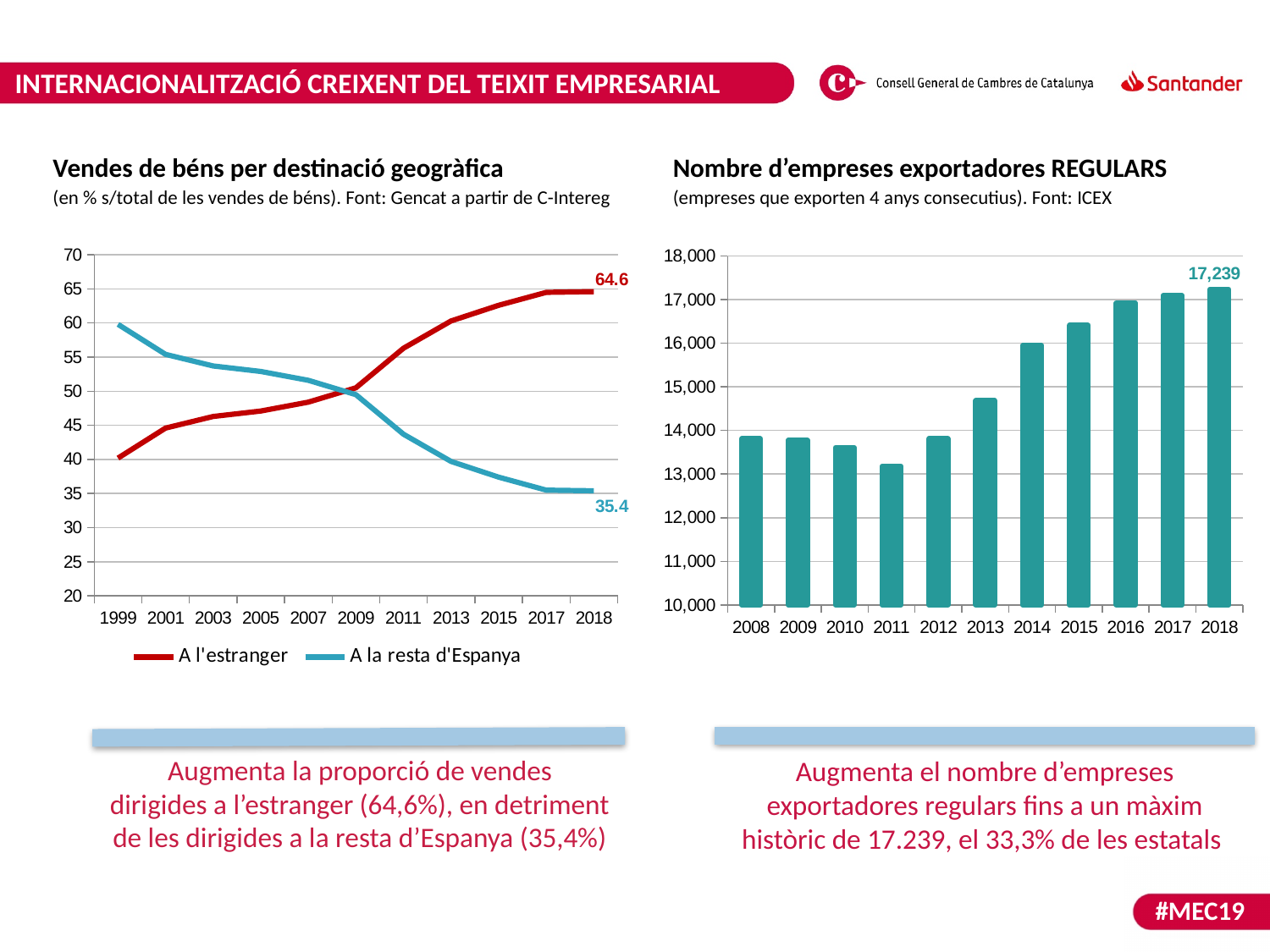
In the 'Vendes de béns per destinació geogràfica' chart, what is the value for 'A l'estranger' in 2018? 64.6 In the 'Vendes de béns per destinació geogràfica' chart, what is the value for 'A la resta d'Espanya' in 2018? 35.4 In the 'Vendes de béns per destinació geogràfica' chart, how many series does the legend list? 2 In the 'Vendes de béns per destinació geogràfica' chart, is the value for 'A l'estranger' in 1999 greater or less than 45? less What kind of chart is 'Vendes de béns per destinació geogràfica'? Line chart In the 'Vendes de béns per destinació geogràfica' chart, what is the difference between the 2018 values of 'A l'estranger' and 'A la resta d'Espanya'? 29.2 In the 'Nombre d'empreses exportadores REGULARS' chart, which year has the lowest value? 2011 In the 'Vendes de béns per destinació geogràfica' chart, does the 'A la resta d'Espanya' series rise or fall from 1999 to 2018? Fall In the 'Nombre d'empreses exportadores REGULARS' chart, what is the value for 2018? 17,239 In the 'Nombre d'empreses exportadores REGULARS' chart, which year has the highest value? 2018 In the 'Nombre d'empreses exportadores REGULARS' chart, is the value for 2014 greater or less than 15,000? greater How many years are shown in the 'Nombre d'empreses exportadores REGULARS' chart? 11